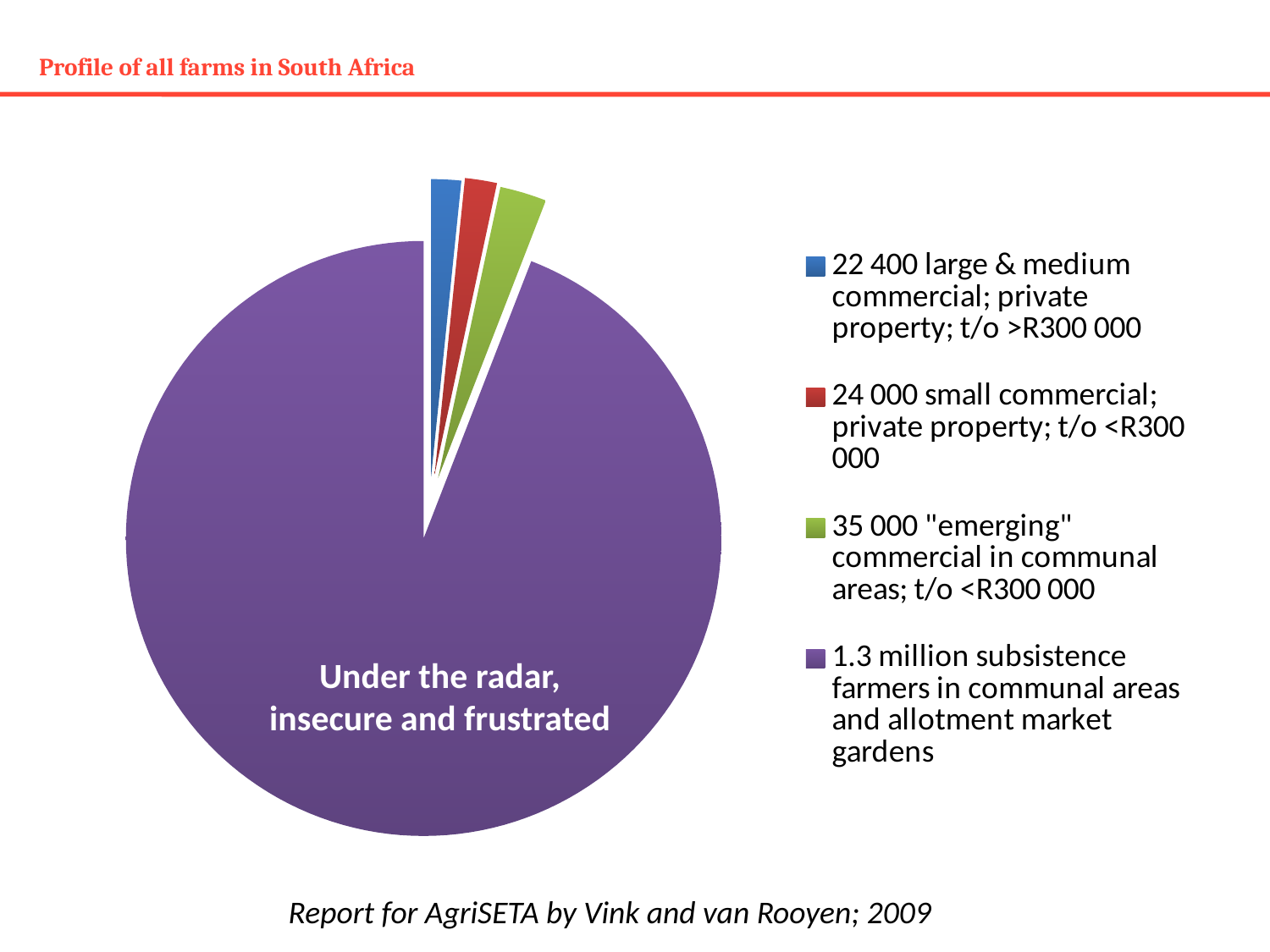
How many slices does the pie chart have? 4 Which category makes up the largest slice of the pie chart? 1.3 million subsistence farmers in communal areas and allotment market gardens What is the difference between the number of "emerging" commercial farms and the number of small commercial farms? 11 000 According to the legend, how many large & medium commercial farms are there? 22 400 According to the legend, how many "emerging" commercial farms in communal areas are there? 35 000 What kind of chart is shown on the slide? Pie chart What text is written inside the largest slice of the pie chart? Under the radar, insecure and frustrated According to the legend, how many small commercial farms are there? 24 000 How many entries does the legend of the pie chart list? 4 Which is larger: the number of small commercial farms or the number of "emerging" commercial farms? "Emerging" commercial farms According to the legend, how many subsistence farmers are there in communal areas and allotment market gardens? 1.3 million Which category makes up the smallest slice of the pie chart? 22 400 large & medium commercial; private property; t/o >R300 000